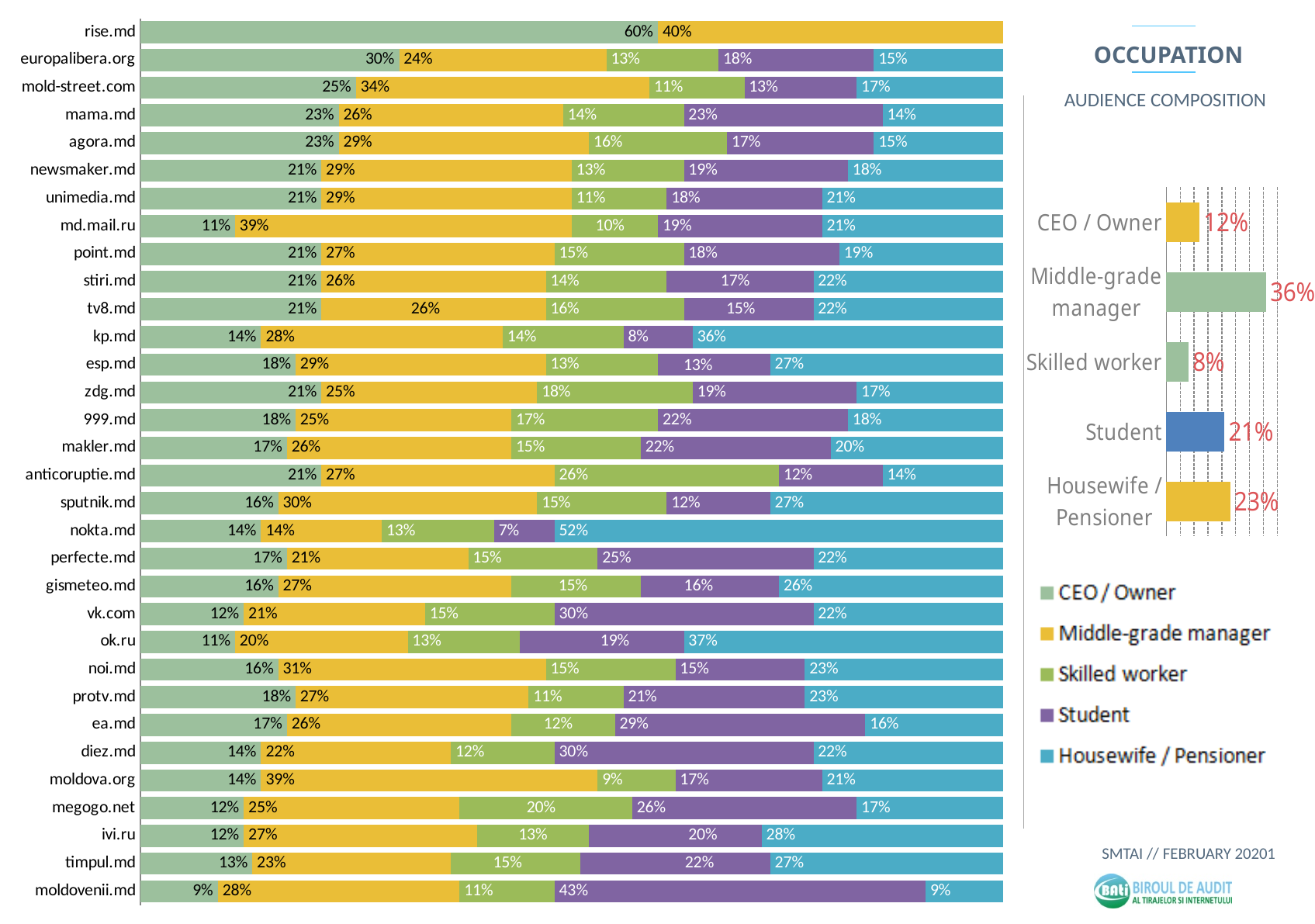
In the Audience Composition chart on the right, what is the difference between the Housewife / Pensioner value and the Student value? 2% In the Audience Composition chart on the right, which occupation has the highest value? Middle-grade manager In the large stacked bar chart on the left, what is the Student share for moldovenii.md? 43% How many occupation categories are shown in the Audience Composition chart on the right? 5 In the large stacked bar chart on the left, which has the larger Housewife / Pensioner share, nokta.md or kp.md? nokta.md In the Audience Composition chart on the right, which occupation has the lowest value? Skilled worker What kind of chart is the large chart on the left? Stacked bar chart How many series does the legend of the large stacked bar chart on the left list? 5 In the large stacked bar chart on the left, what is the Housewife / Pensioner share for nokta.md? 52% In the large stacked bar chart on the left, what is the Middle-grade manager share for rise.md? 40% In the large stacked bar chart on the left, which website has the highest CEO / Owner share? rise.md In the Audience Composition chart on the right, what is the value for Middle-grade manager? 36%